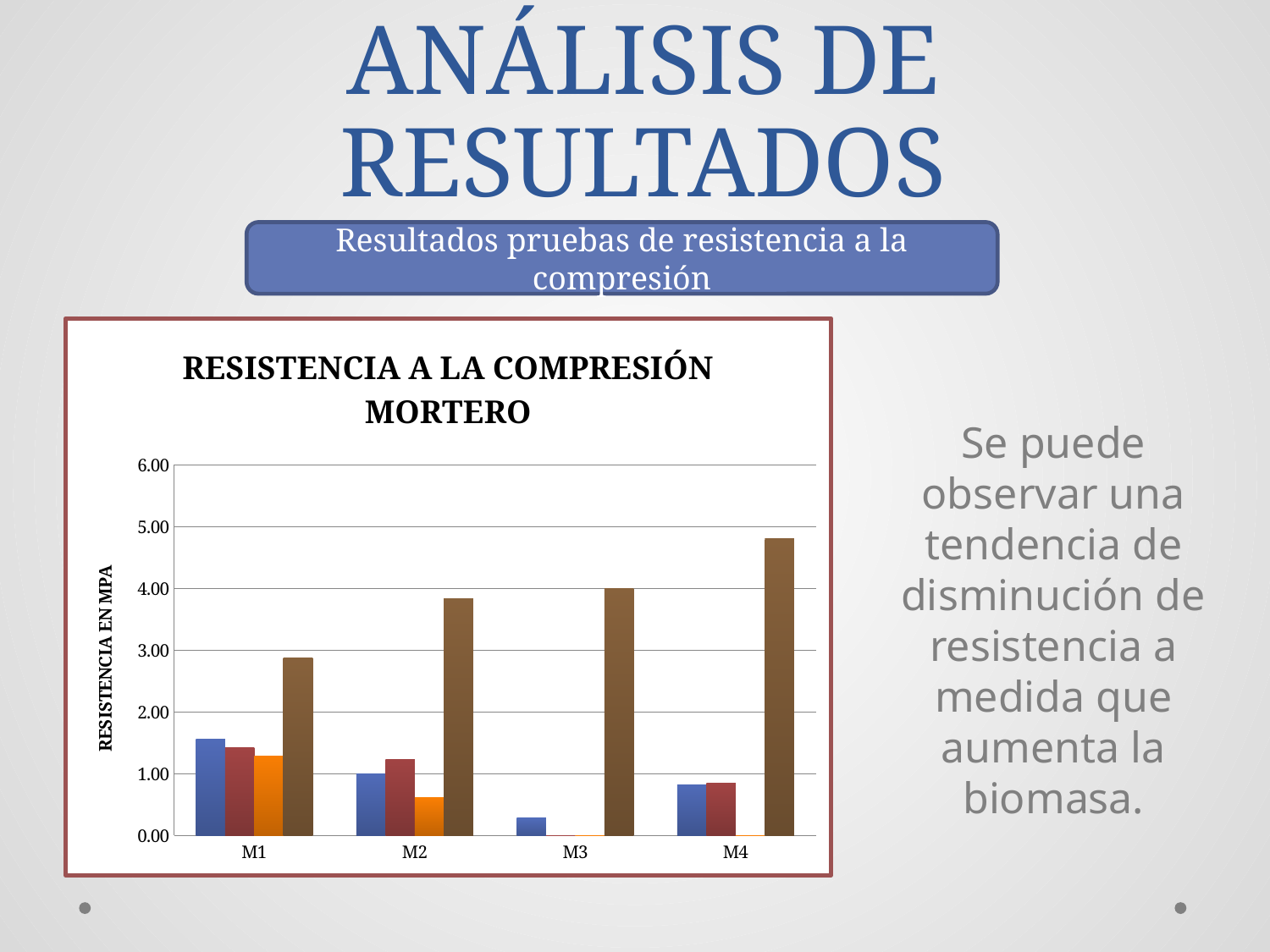
Is the value of the blue bar for M3 greater or less than 1.00? less Which is larger, the blue bar for M1 or the blue bar for M3? M1 Which category has the tallest bar in the chart? M4 What kind of chart is shown on the slide? bar chart Is the value of the brown bar for M2 greater or less than 3.00? greater Is the value of the brown bar for M4 greater or less than 4.00? greater Which category has the tallest brown bar? M4 Do the brown bars rise or fall from M1 to M4? rise What is the label on the vertical axis of the chart? RESISTENCIA EN MPA How many categories are shown on the x axis of the chart? 4 What is the title of the chart? RESISTENCIA A LA COMPRESIÓN MORTERO Which category has the shortest blue bar? M3